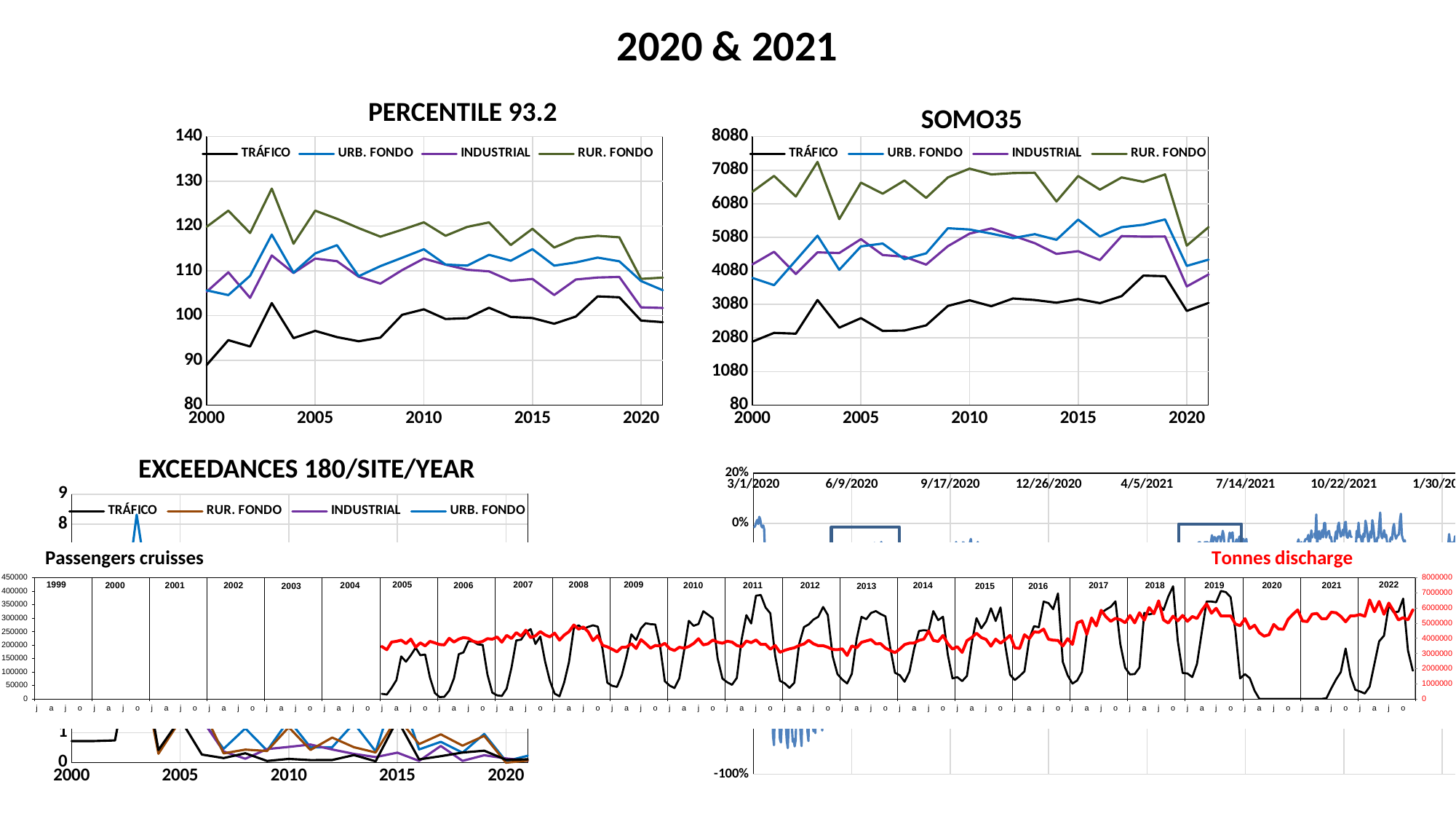
What is the title of the chart at the top right of the slide? SOMO35 How many series does the legend of the PERCENTILE 93.2 chart list? 4 In the PERCENTILE 93.2 chart, is the value for RUR. FONDO in 2003 greater or less than 120? greater In the SOMO35 chart, does the TRÁFICO series overall rise or fall from 2000 to 2021? rise In the PERCENTILE 93.2 chart, which series has the highest values across the years shown? RUR. FONDO What kind of chart is the PERCENTILE 93.2 chart? line chart In the SOMO35 chart, is the value for RUR. FONDO in 2003 greater or less than 7080? greater In the PERCENTILE 93.2 chart, does the RUR. FONDO series overall rise or fall from 2000 to 2021? fall In the PERCENTILE 93.2 chart, which series has the lowest values across the years shown? TRÁFICO How many series does the legend of the EXCEEDANCES 180/SITE/YEAR chart list? 4 In the SOMO35 chart, which series has the highest values across the years shown? RUR. FONDO In the SOMO35 chart, is the value for TRÁFICO in 2000 greater or less than 2080? less